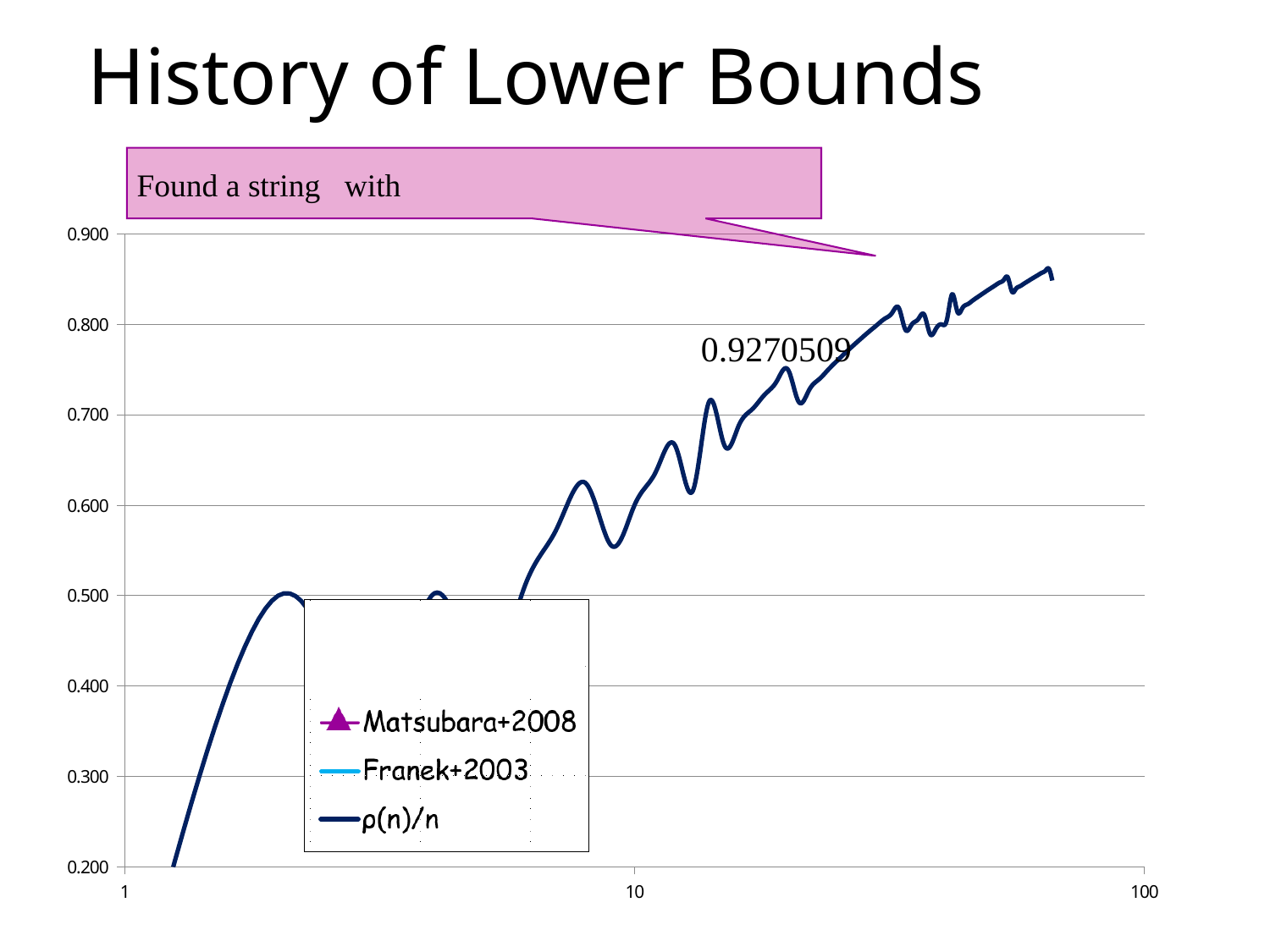
Is the value of ρ(n)/n at x = 10 greater or less than 0.700? less Is the highest value reached by the ρ(n)/n line greater or less than 0.900? less Is the highest value reached by the ρ(n)/n line greater or less than 0.800? greater What kind of chart is shown on the slide? line chart What is the lowest value shown on the chart's y axis? 0.200 Which series are listed in the chart legend? Matsubara+2008, Franek+2003, ρ(n)/n Does the ρ(n)/n line generally rise or fall as x increases along the x axis? rise How many series does the chart legend list? 3 What is the highest tick value shown on the chart's x axis? 100